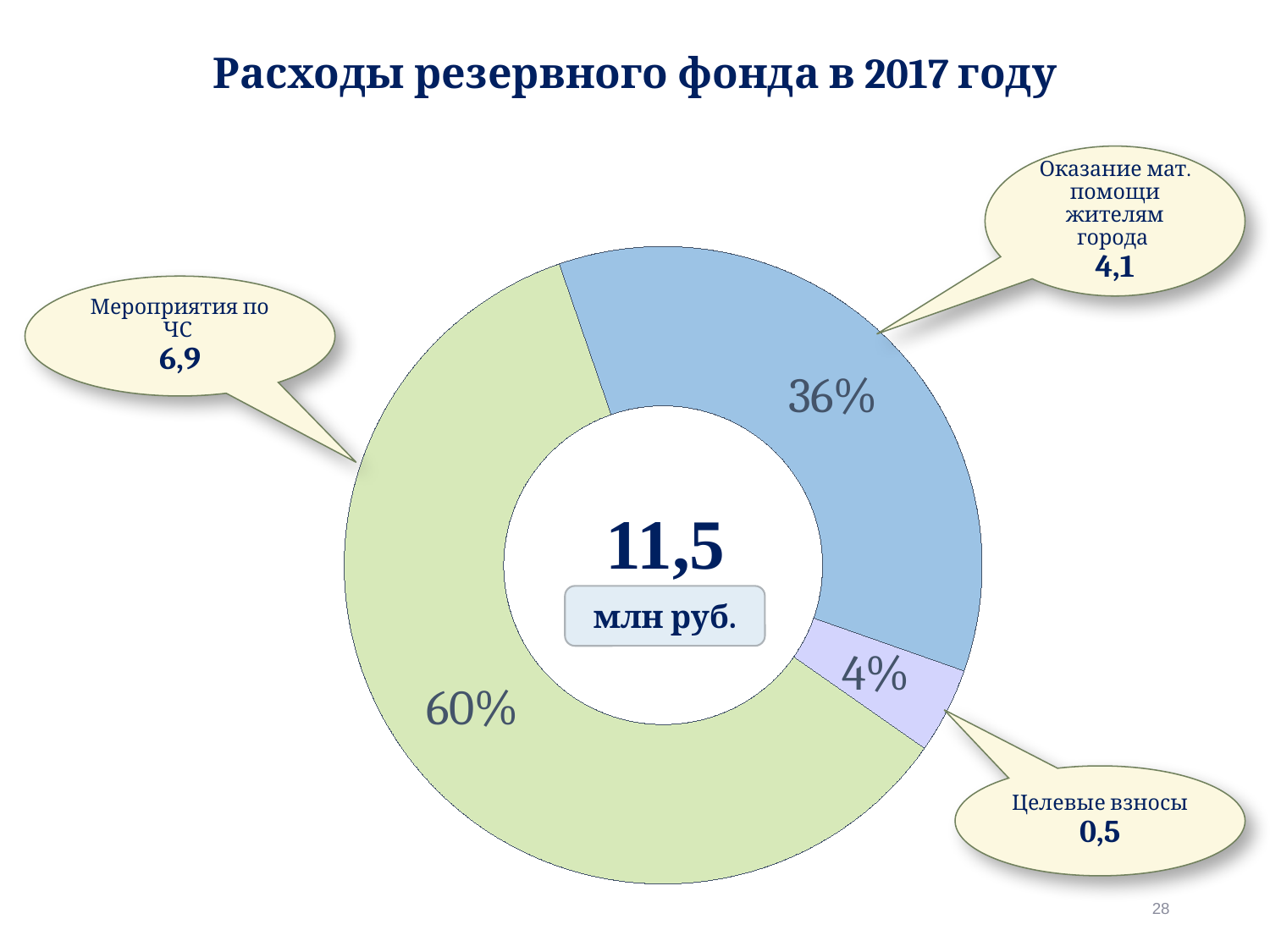
What total value is shown in the centre of the chart? 11,5 млн руб. What is the value shown for "Мероприятия по ЧС"? 6,9 How many slices does the chart have? 3 What is the title of the chart on the slide? Расходы резервного фонда в 2017 году What kind of chart is shown on the slide? Pie (doughnut) chart What share of the chart does "Оказание мат. помощи жителям города" take? 36% What is the value shown for "Оказание мат. помощи жителям города"? 4,1 What is the value shown for "Целевые взносы"? 0,5 Which category has the largest slice? Мероприятия по ЧС Which category has the smallest slice? Целевые взносы What share of the chart does "Целевые взносы" take? 4% What share of the chart does "Мероприятия по ЧС" take? 60%